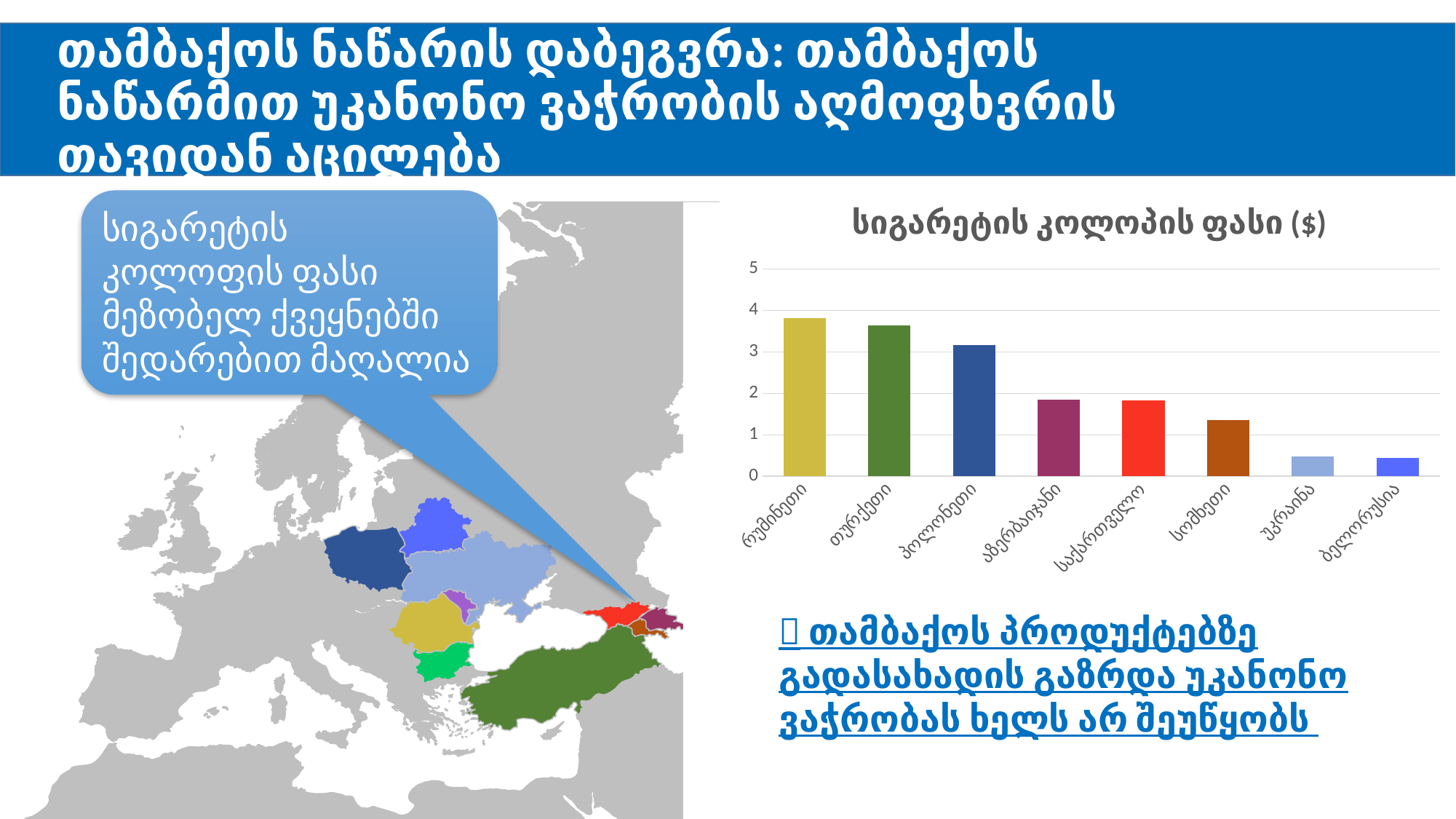
Which is larger, the value for პოლონეთი or the value for უკრაინა? პოლონეთი Which is larger, the value for საქართველო or the value for თურქეთი? თურქეთი Which country has the highest cigarette pack price in the chart? რუმინეთი How many countries are shown in the chart? 8 Is the value for თურქეთი greater or less than 4? less What is the title of the chart? სიგარეტის კოლოპის ფასი ($) What kind of chart is shown on the slide? bar chart Do the values rise or fall from left to right along the x axis? fall Is the value for რუმინეთი greater or less than 3? greater Is the value for უკრაინა greater or less than 1? less